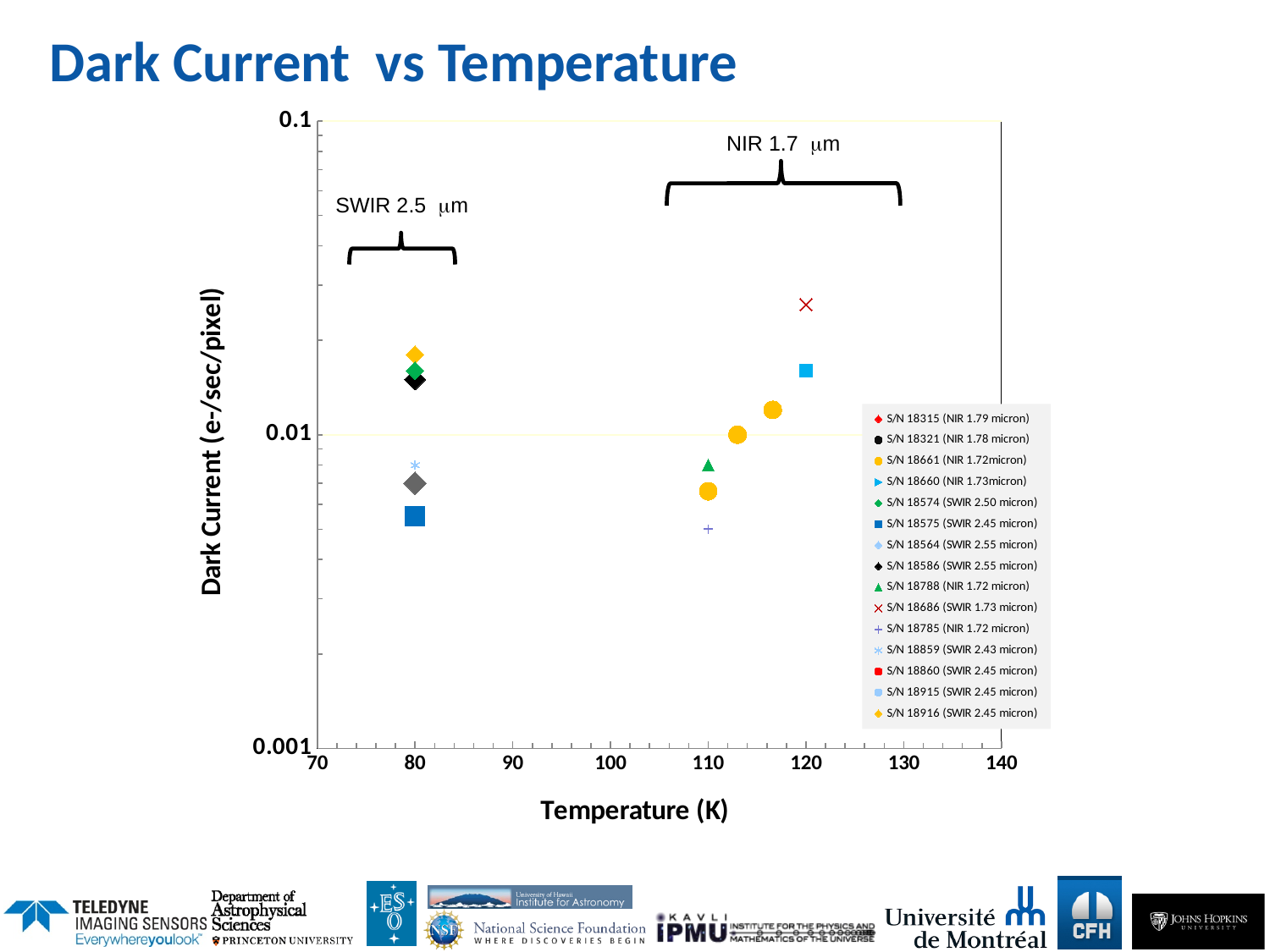
Is the dark current for S/N 18916 (SWIR 2.45 micron) greater or less than 0.01? greater Is the dark current for S/N 18785 (NIR 1.72 micron) greater or less than 0.01? less At what temperature are the SWIR 2.5 µm points plotted? 80 Is the dark current for S/N 18575 (SWIR 2.45 micron) greater or less than 0.01? less How many series does the chart legend list? 15 Which series has the highest dark current plotted on the chart? S/N 18686 (SWIR 1.73 micron) What kind of chart is shown on the slide? scatter chart What is the title of the chart? Dark Current vs Temperature At 120 K, which has the higher dark current: S/N 18686 or S/N 18915? S/N 18686 Does the dark current for S/N 18661 (NIR 1.72 micron) rise or fall as temperature increases? rise What is the label of the x axis? Temperature (K)